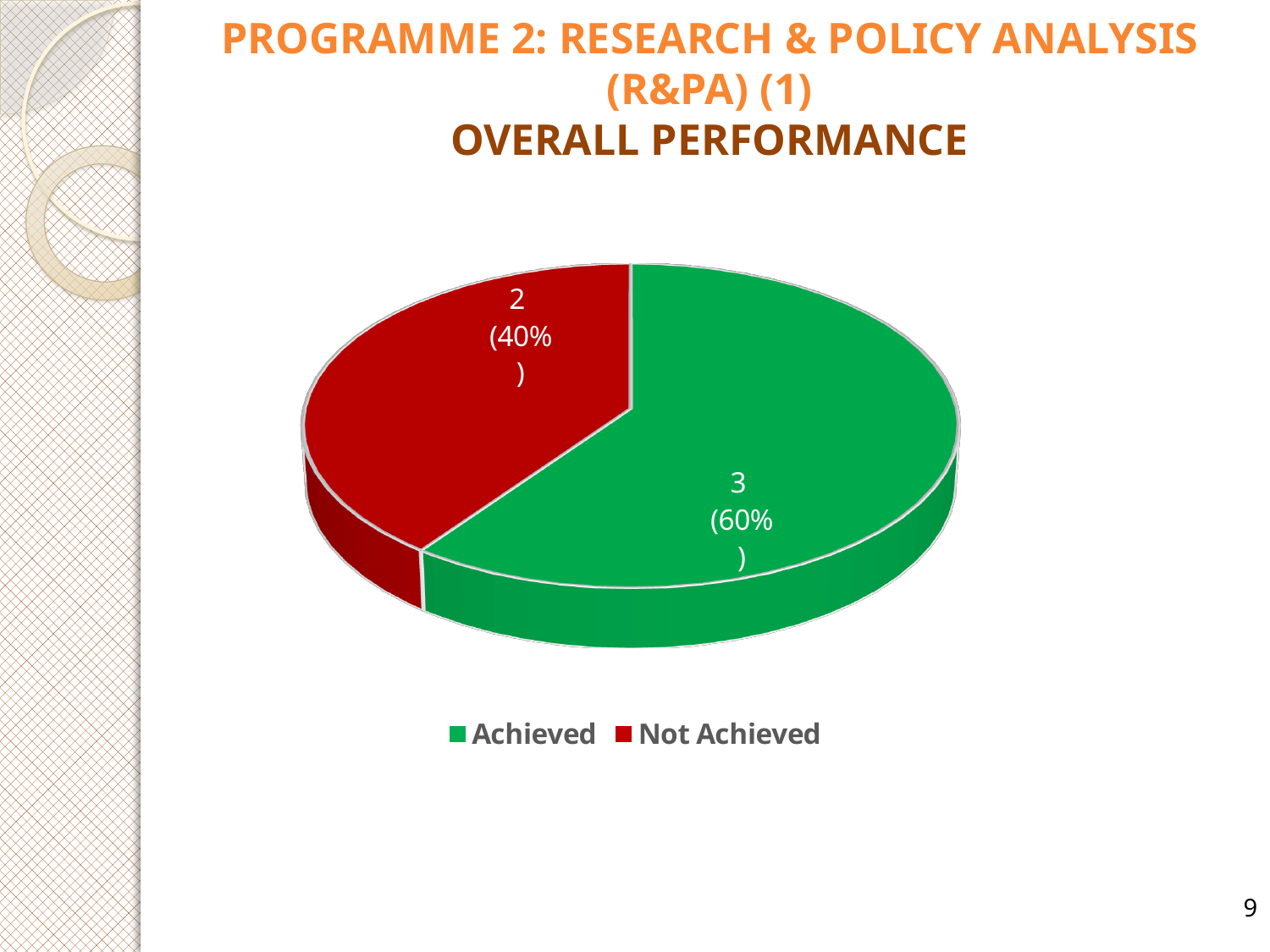
What is the total of the values shown in the pie chart? 5 What kind of chart is shown on the slide? Pie chart What share of the pie does the Not Achieved slice represent? 40% Which slice is larger, Achieved or Not Achieved? Achieved How many categories does the pie chart show? 2 What share of the pie does the Achieved slice represent? 60% What is the difference between the Achieved and Not Achieved counts? 1 What colour is the Achieved slice? Green How many targets were Achieved according to the pie chart? 3 Which category has the smallest slice in the pie chart? Not Achieved What are the two entries listed in the legend? Achieved and Not Achieved How many targets were Not Achieved according to the pie chart? 2